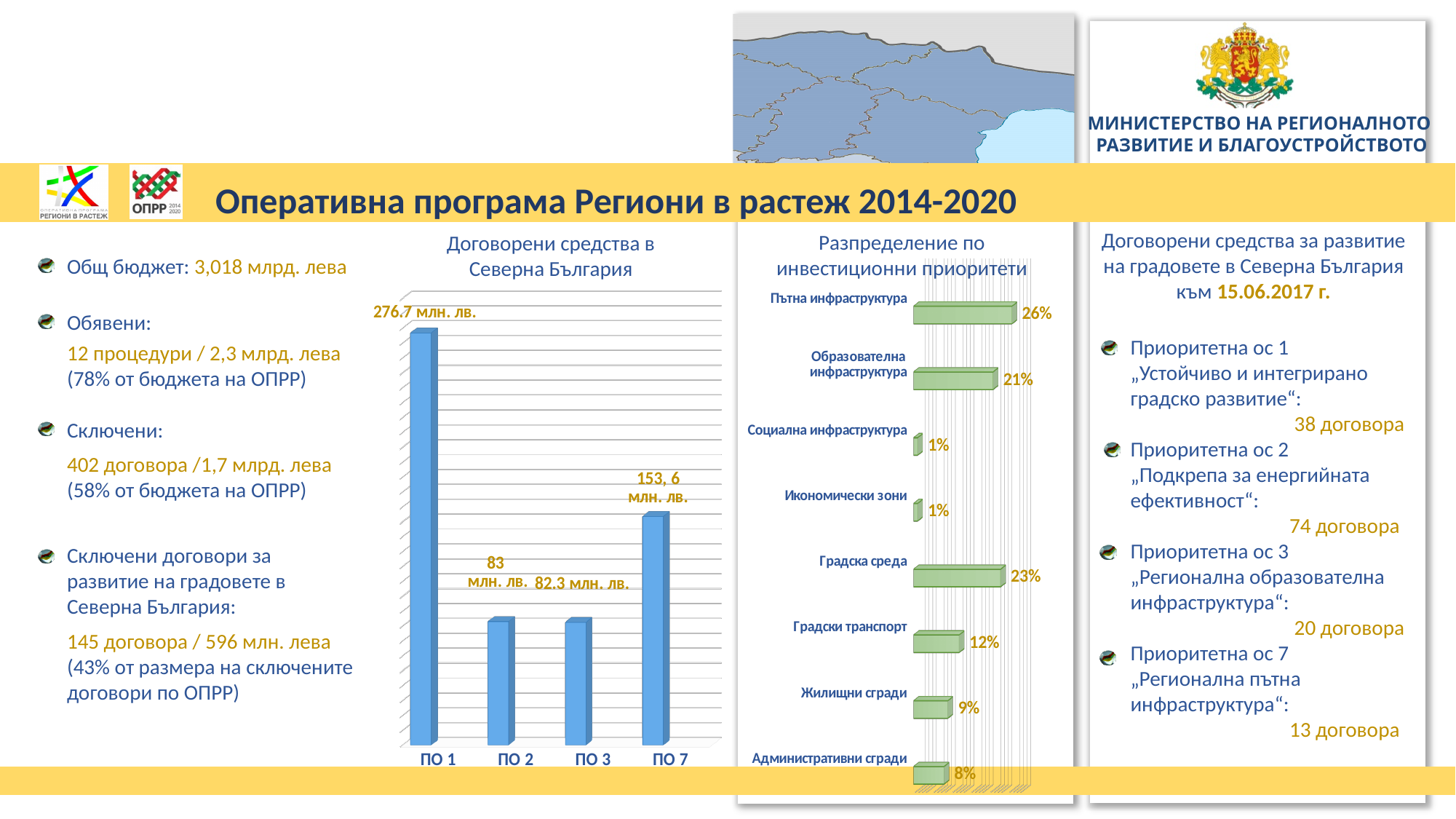
In the chart 'Договорени средства в Северна България', is the value for ПО 1 larger or smaller than the value for ПО 7? larger In the chart 'Договорени средства в Северна България', how many categories are shown on the x axis? 4 In the chart 'Договорени средства в Северна България', what is the value for ПО 1? 276.7 млн. лв. In the chart 'Договорени средства в Северна България', which category has the highest value? ПО 1 What kind of chart is 'Договорени средства в Северна България'? bar chart In the chart 'Разпределение по инвестиционни приоритети', how many categories are shown? 8 In the chart 'Разпределение по инвестиционни приоритети', what is the value for Пътна инфраструктура? 26% In the chart 'Договорени средства в Северна България', what is the value for ПО 7? 153, 6 млн. лв. In the chart 'Разпределение по инвестиционни приоритети', which category has the highest value? Пътна инфраструктура In the chart 'Разпределение по инвестиционни приоритети', what is the difference between Градска среда and Образователна инфраструктура? 2% In the chart 'Разпределение по инвестиционни приоритети', is the value for Жилищни сгради larger or smaller than the value for Административни сгради? larger In the chart 'Разпределение по инвестиционни приоритети', what is the value for Градски транспорт? 12%